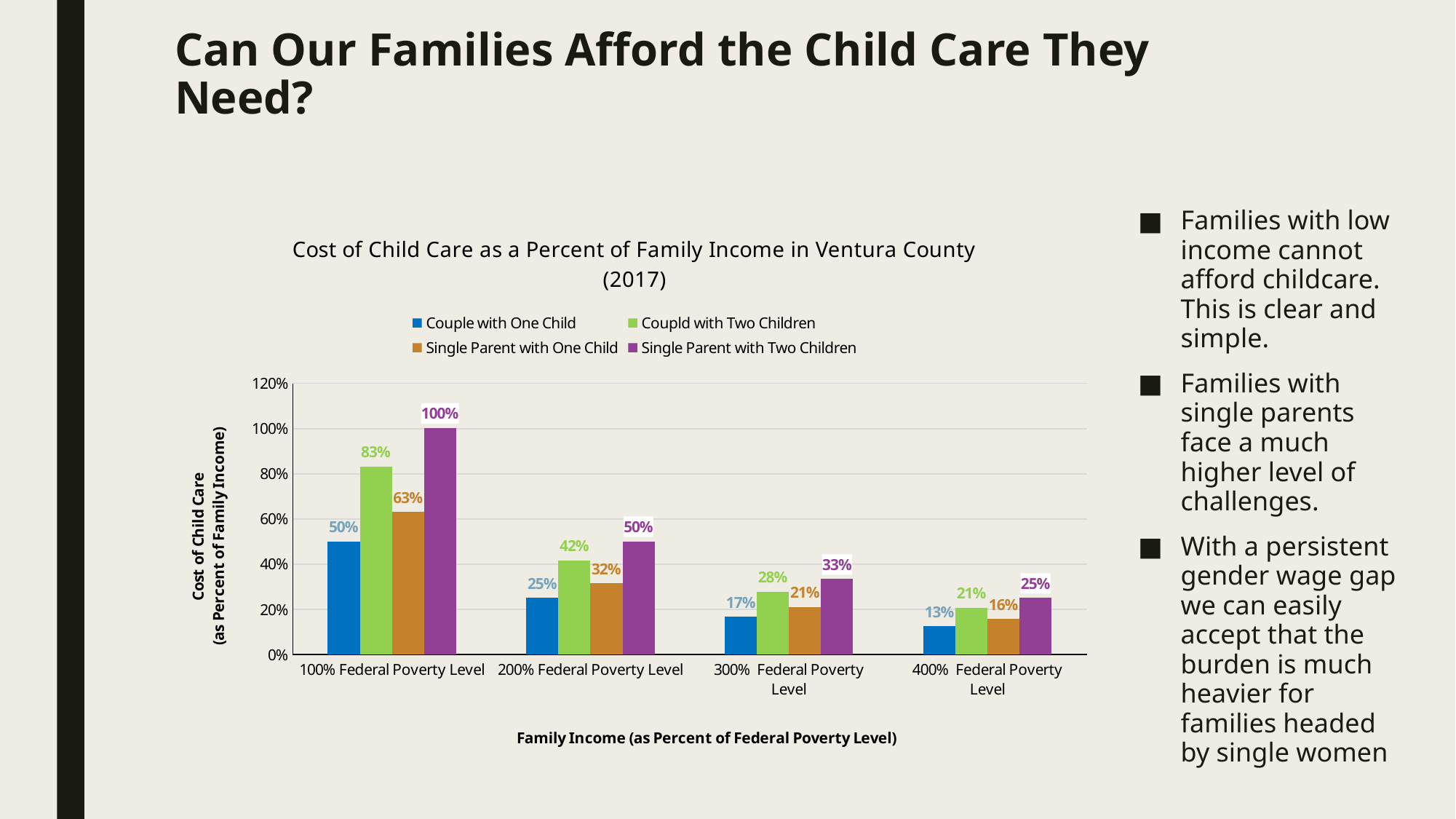
Is the value for Single Parent with One Child at 100% Federal Poverty Level greater or less than 60%? greater Do the values for Couple with One Child rise or fall as the Federal Poverty Level increases from 100% to 400%? Fall What is the value for Single Parent with One Child at 300% Federal Poverty Level? 21% Which series has the lowest value at 100% Federal Poverty Level? Couple with One Child What is the value for Single Parent with Two Children at 100% Federal Poverty Level? 100% Which series has the highest value at 400% Federal Poverty Level? Single Parent with Two Children What is the value for Couple with One Child at 200% Federal Poverty Level? 25% What is the difference between Coupld with Two Children and Couple with One Child at 100% Federal Poverty Level? 33% Which is larger at 200% Federal Poverty Level: Coupld with Two Children or Single Parent with One Child? Coupld with Two Children How many Federal Poverty Level categories are shown on the x axis? 4 How many series does the legend list? 4 What kind of chart is shown on the slide? Bar chart